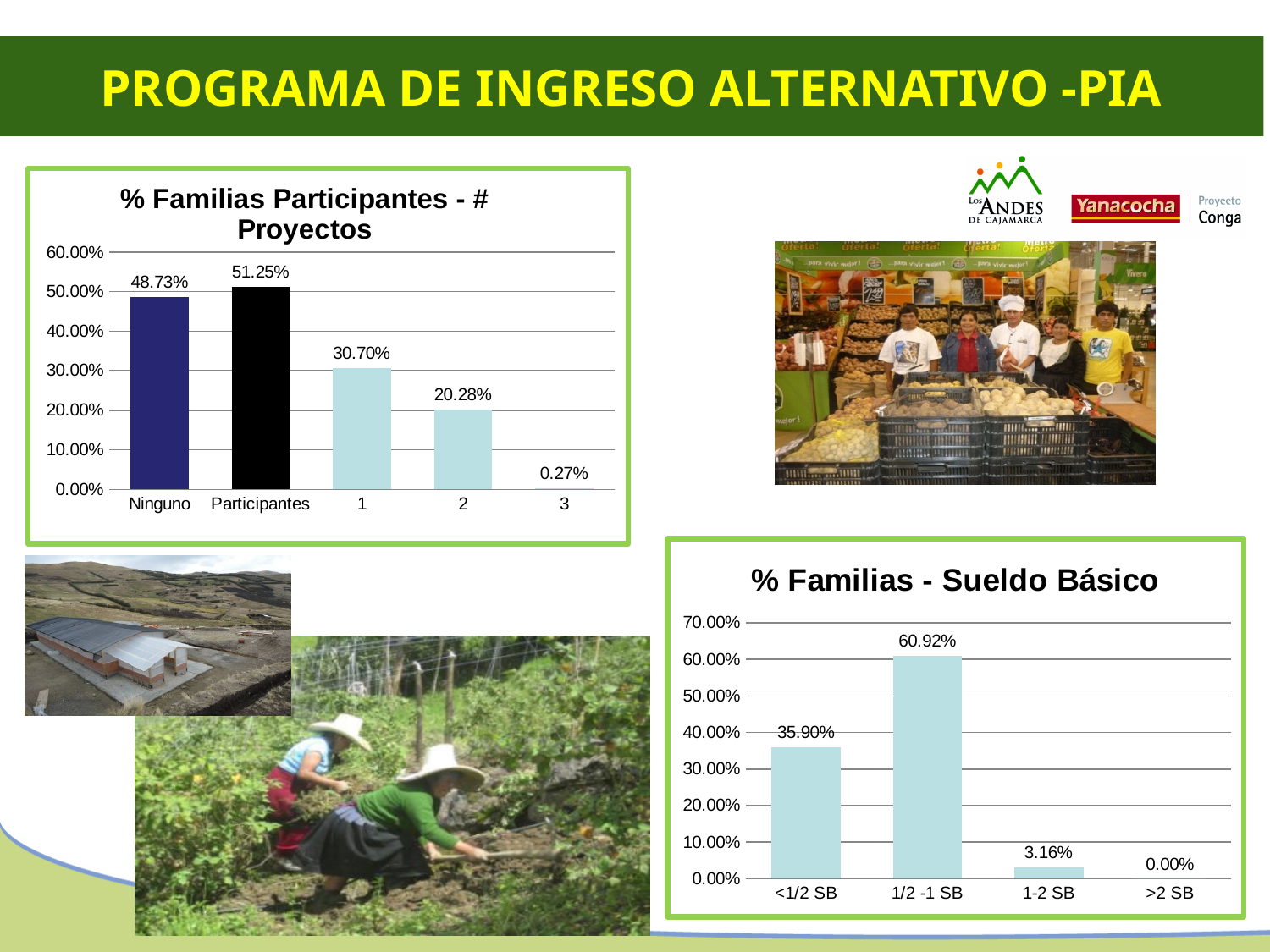
In the '% Familias - Sueldo Básico' chart, what is the difference between 1/2 -1 SB and <1/2 SB? 25.02% In the '% Familias Participantes - # Proyectos' chart, what is the value for Participantes? 51.25% What type of chart is the '% Familias - Sueldo Básico' chart? Bar chart In the '% Familias Participantes - # Proyectos' chart, is the value for category 1 greater or less than 40.00%? less In the '% Familias - Sueldo Básico' chart, which is larger, <1/2 SB or 1-2 SB? <1/2 SB In the '% Familias Participantes - # Proyectos' chart, what is the difference between Participantes and Ninguno? 2.52% In the '% Familias Participantes - # Proyectos' chart, which category has the lowest value? 3 In the '% Familias Participantes - # Proyectos' chart, what is the value for category 2? 20.28% In the '% Familias Participantes - # Proyectos' chart, how many categories are shown on the x axis? 5 In the '% Familias - Sueldo Básico' chart, which category has the highest value? 1/2 -1 SB In the '% Familias - Sueldo Básico' chart, what is the value for >2 SB? 0.00% In the '% Familias - Sueldo Básico' chart, what is the value for 1/2 -1 SB? 60.92%